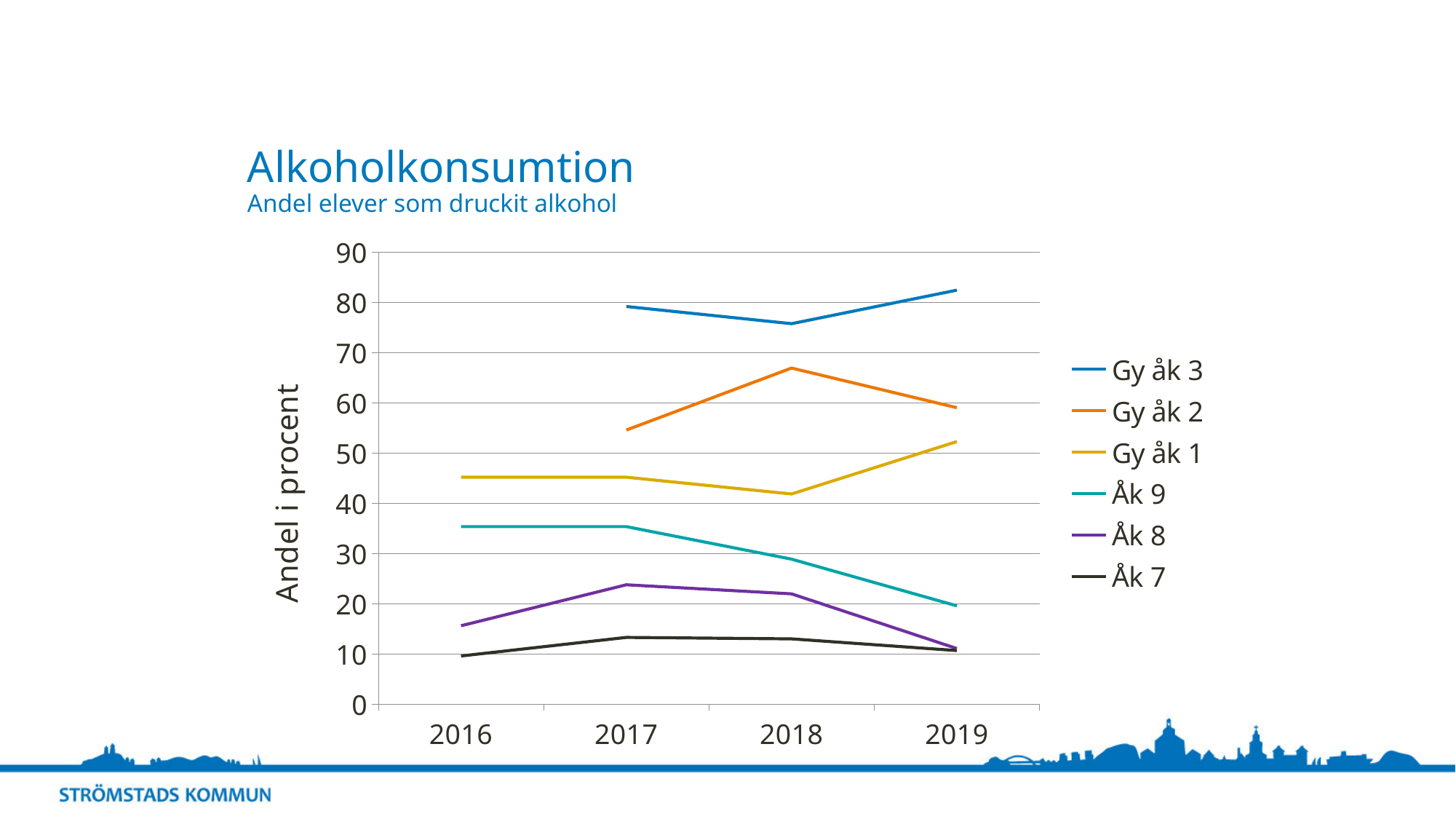
What kind of chart is shown on the slide? line chart What is the title of the y axis? Andel i procent In 2018, which is larger: the value for Gy åk 1 or the value for Åk 9? Gy åk 1 What is the title of the chart? Alkoholkonsumtion Is the value for Gy åk 2 in 2018 greater or less than 60? greater How many years are shown on the x axis? 4 Is the value for Åk 9 in 2019 greater or less than 30? less Is the value for Åk 8 in 2017 greater or less than 20? greater Which series has the lowest value in 2016? Åk 7 Does the value for Åk 9 rise or fall from 2017 to 2019? fall Which series has the highest value in 2019? Gy åk 3 How many series does the legend list? 6